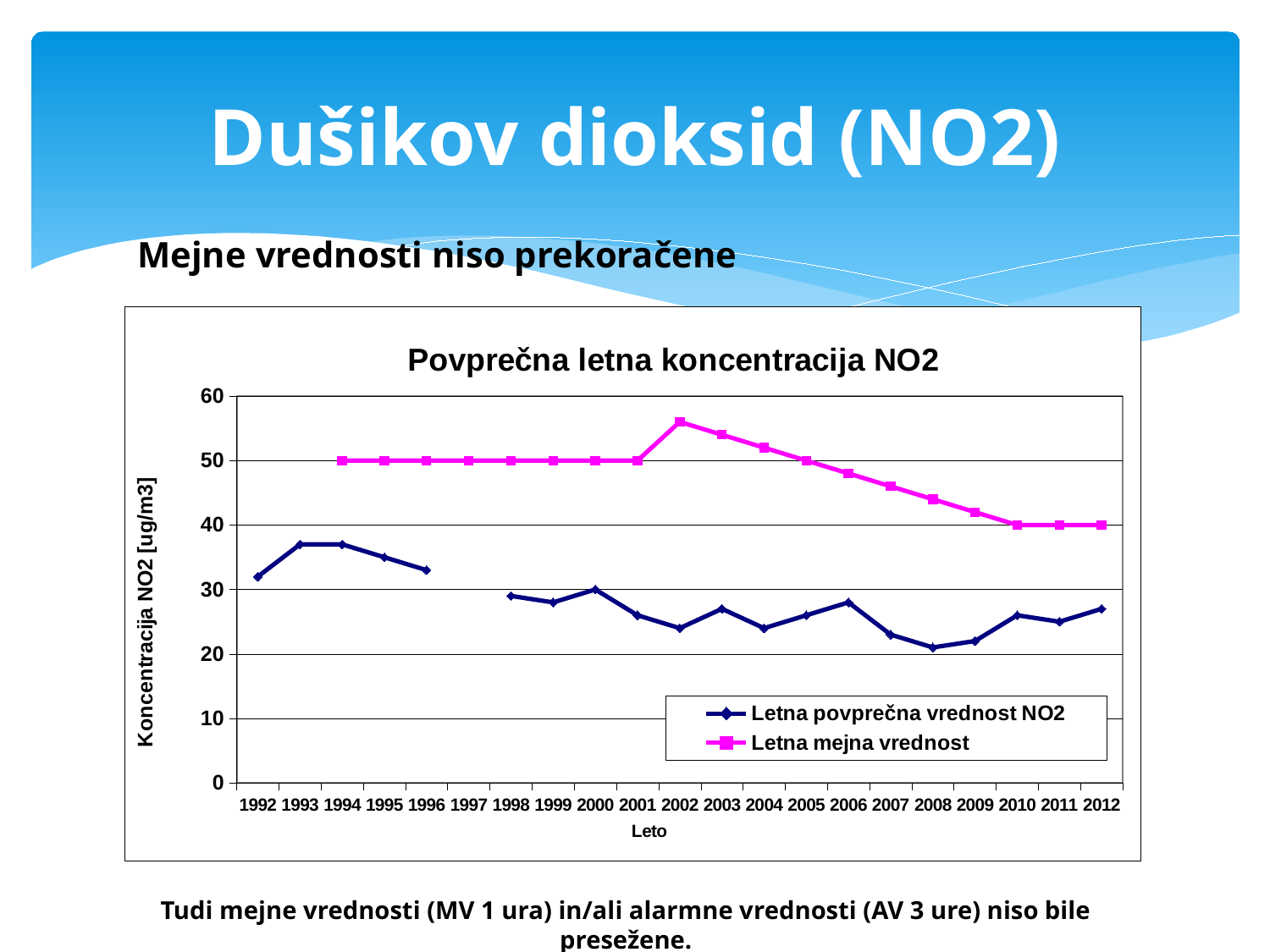
In which year is Letna mejna vrednost highest? 2002 What is the value of Letna mejna vrednost in 1994? 50 What kind of chart is shown on the slide? line chart Which is larger in 2002: Letna mejna vrednost or Letna povprečna vrednost NO2? Letna mejna vrednost What is the value of Letna mejna vrednost in 2012? 40 Does Letna mejna vrednost rise or fall from 2002 to 2010? fall Is the value for Letna povprečna vrednost NO2 in 2008 greater or less than 30? less How many years are shown on the x axis? 21 Is the value for Letna povprečna vrednost NO2 in 1993 greater or less than 30? greater In which year is Letna povprečna vrednost NO2 lowest? 2008 How many series does the legend list? 2 What is the title of the chart? Povprečna letna koncentracija NO2